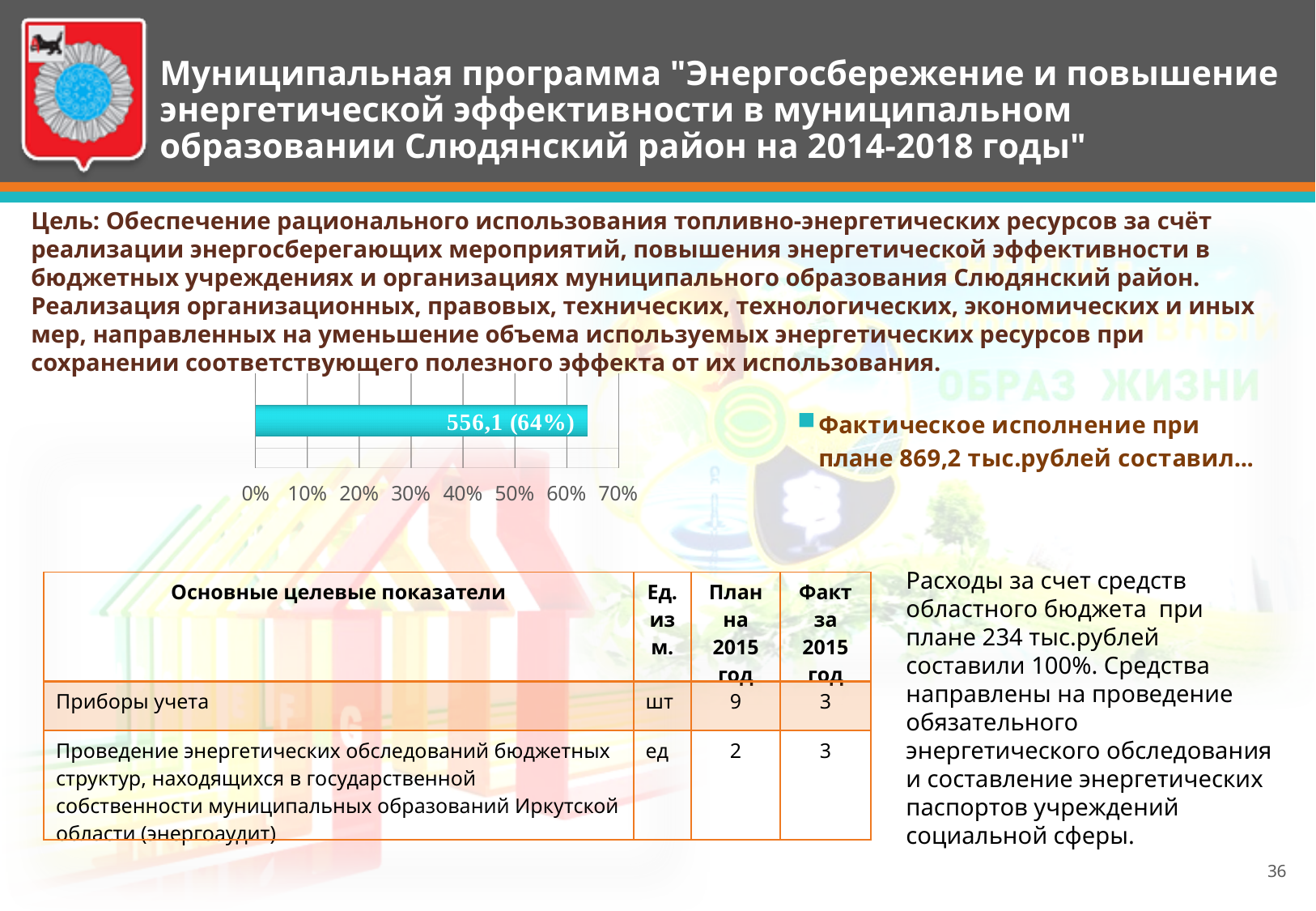
Is the value of the bar greater or less than 50%? greater According to the chart's legend, what is the planned amount in thousand rubles? 869,2 тыс.рублей How many series does the chart's legend list? 1 What percentage is shown in the data label on the bar? 64% How many bars are plotted in the chart? 1 What colour is the bar in the chart? cyan What kind of chart is shown on the slide? bar chart Is the value of the bar greater or less than 70%? less What data label is printed on the bar in the chart? 556,1 (64%) What is the highest tick value shown on the chart's x axis? 70%